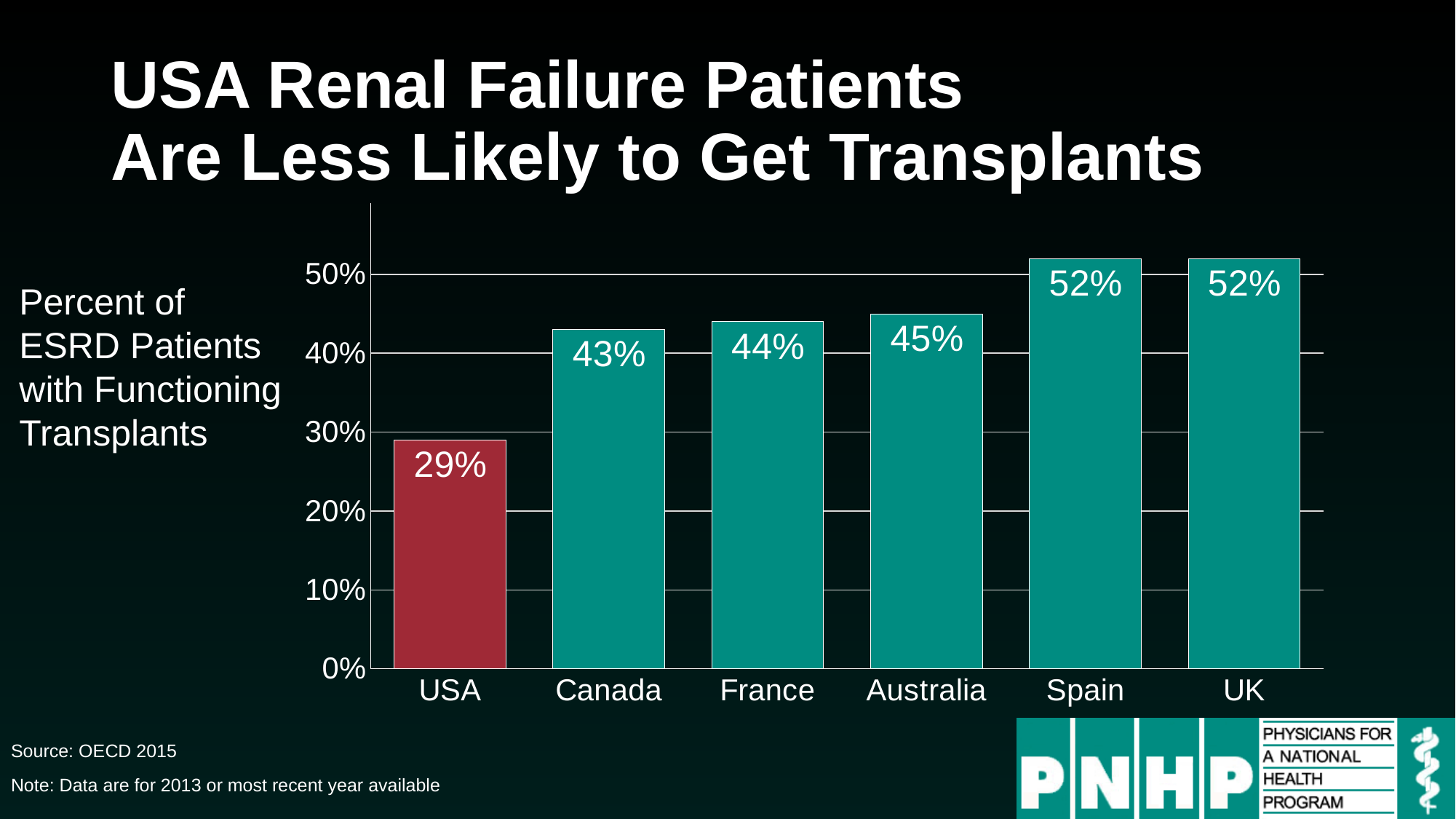
What kind of chart is shown on the slide? Bar chart What is the value shown for Canada? 43% What is the difference between the values for Australia and Canada? 2% Is the value for USA greater or less than 30%? less What is the value shown for Australia? 45% Which country has the lowest percent of ESRD patients with functioning transplants? USA What percent of ESRD patients in the USA have functioning transplants? 29% Which is larger, the value for France or the value for Canada? France Which bar is coloured differently from the others? USA Is the value for Spain greater or less than 50%? greater What is the difference between the values for the UK and the USA? 23% How many countries are shown in the chart? 6